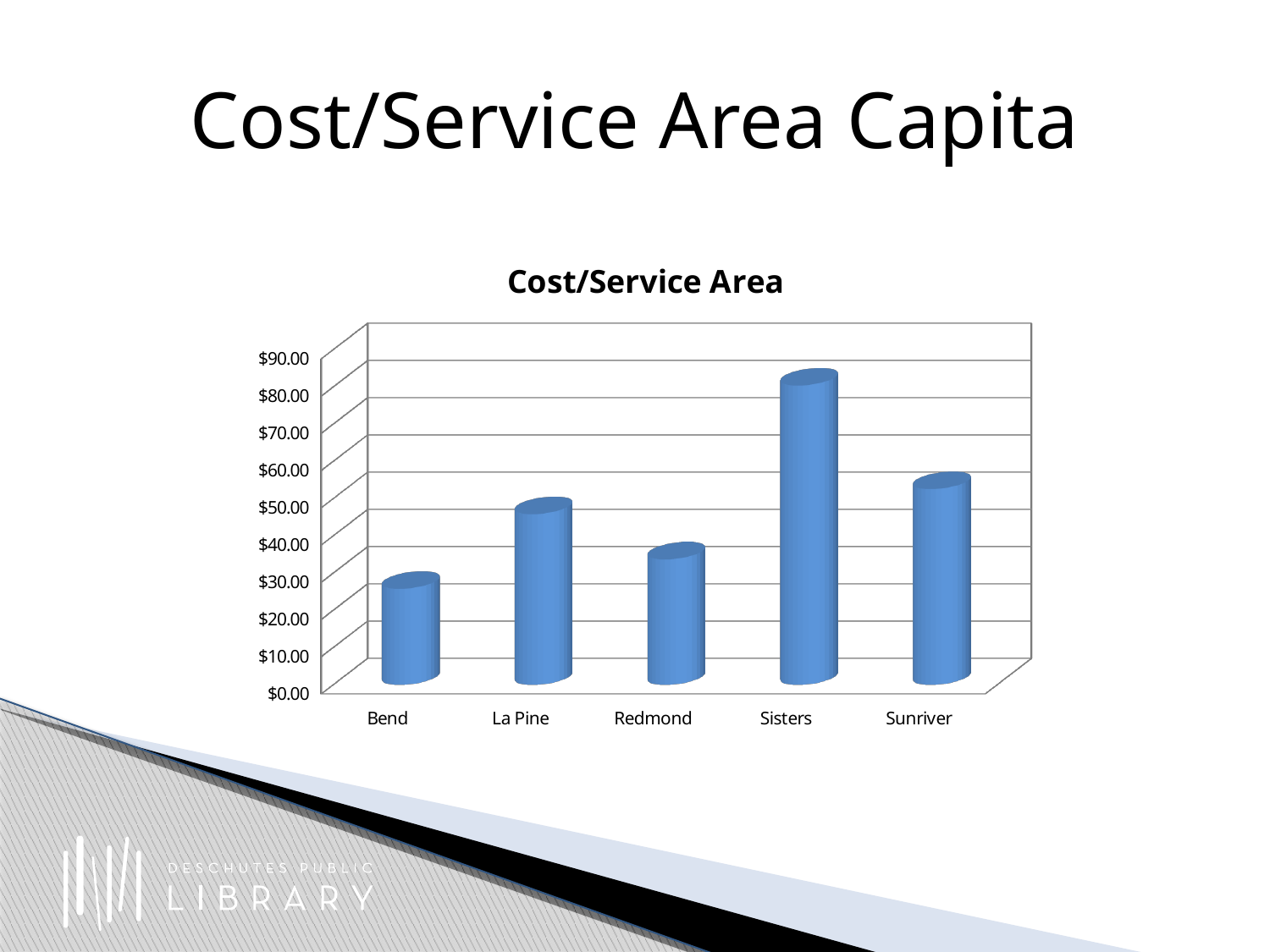
Is the value for Bend greater or less than $40.00? less How many service areas are plotted on the chart? 5 What kind of chart is shown on the slide? bar chart Is the value for La Pine greater or less than $40.00? greater Which service area has the lowest cost per capita? Bend Is the value for Sunriver greater or less than $60.00? less Which service area has the highest cost per capita? Sisters Which has a higher cost per capita, La Pine or Redmond? La Pine What is the title of the chart? Cost/Service Area Which has a higher cost per capita, Sisters or Sunriver? Sisters